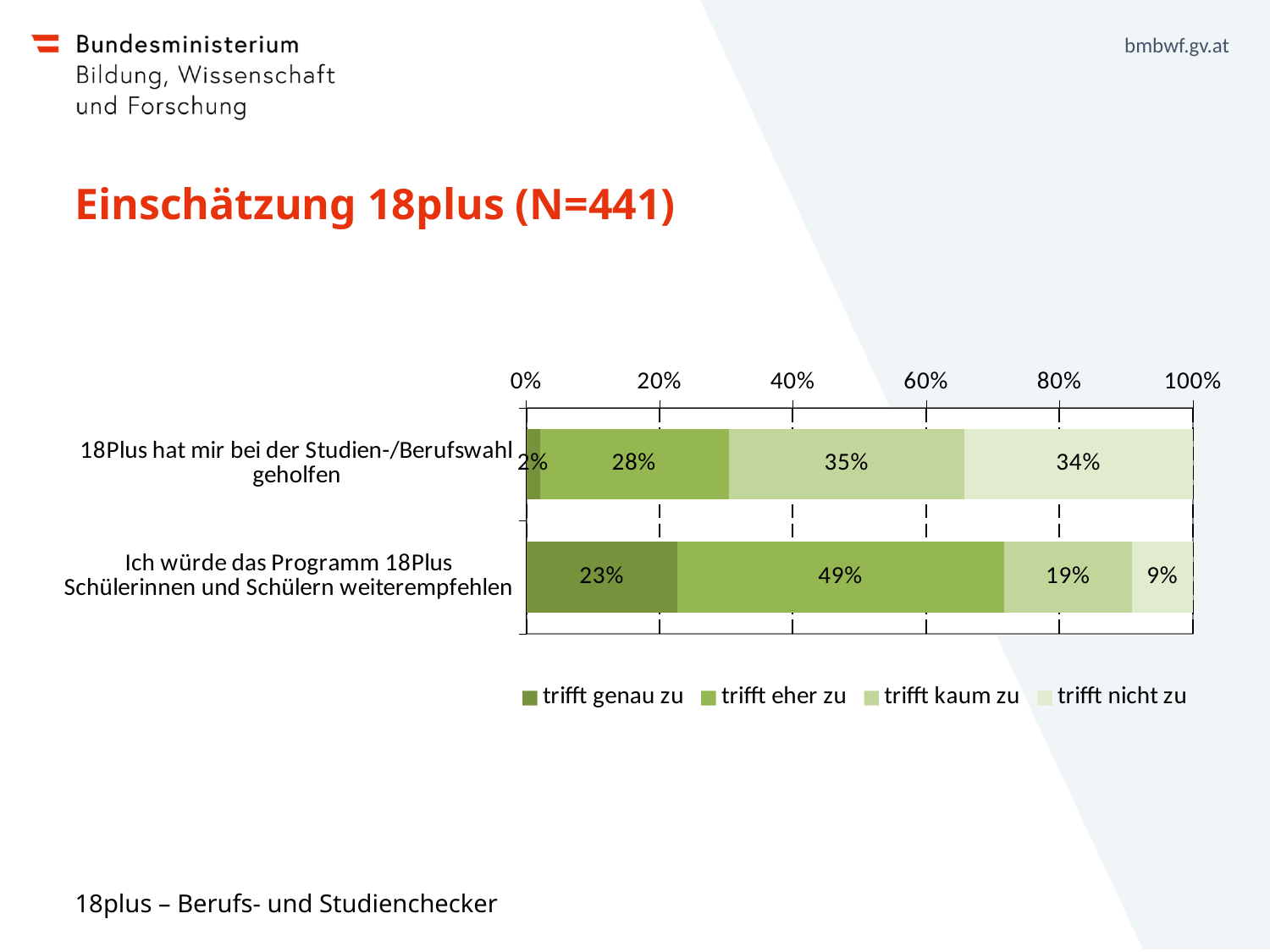
Which response category has the smallest share for the statement "18Plus hat mir bei der Studien-/Berufswahl geholfen"? trifft genau zu What is the value for "trifft kaum zu" for the statement "Ich würde das Programm 18Plus Schülerinnen und Schülern weiterempfehlen"? 19% Which response category has the largest share for the statement "Ich würde das Programm 18Plus Schülerinnen und Schülern weiterempfehlen"? trifft eher zu What is the difference between the "trifft eher zu" values of the two statements? 21 percentage points How many categories (statements) are plotted in the chart? 2 What is the value for "trifft nicht zu" for the statement "18Plus hat mir bei der Studien-/Berufswahl geholfen"? 34% Which statement has the larger "trifft genau zu" share? Ich würde das Programm 18Plus Schülerinnen und Schülern weiterempfehlen What is the value for "trifft eher zu" for the statement "18Plus hat mir bei der Studien-/Berufswahl geholfen"? 28% What kind of chart is shown on the slide? stacked bar chart What is the value for "trifft genau zu" for the statement "Ich würde das Programm 18Plus Schülerinnen und Schülern weiterempfehlen"? 23% What is the title of the slide containing the chart? Einschätzung 18plus (N=441) How many series does the legend list? 4